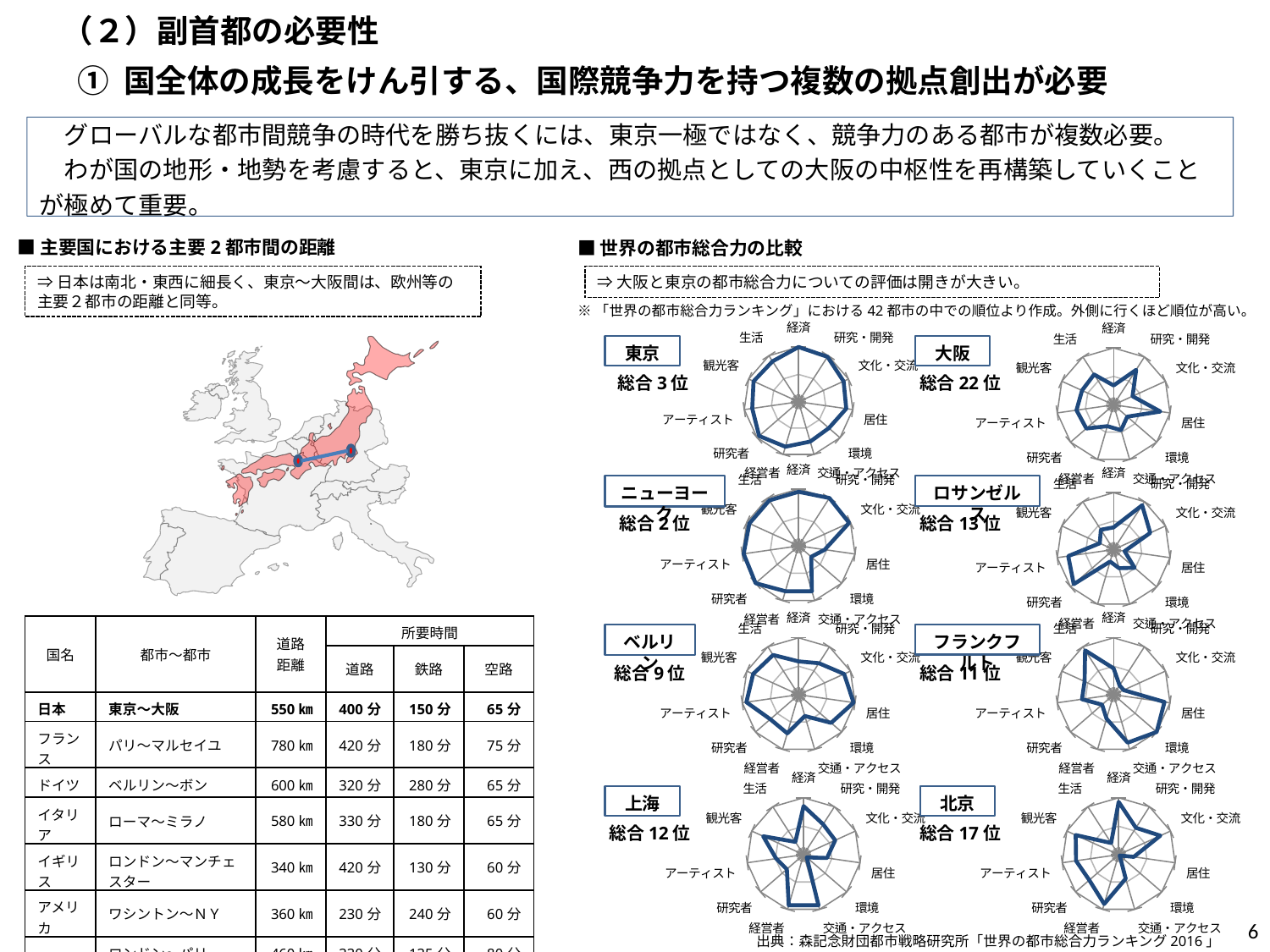
In the 「世界の都市総合力の比較」 section, what overall rank (総合) is printed next to the 大阪 radar chart? 総合 22 位 In the 「世界の都市総合力の比較」 section, what overall rank (総合) is printed next to the ニューヨーク radar chart? 総合 2 位 In the 「世界の都市総合力の比較」 section, what overall rank (総合) is printed next to the 上海 radar chart? 総合 12 位 In the 「世界の都市総合力の比較」 section, which city's radar chart is labelled with the worst (highest-numbered) overall rank? 大阪 What kind of chart is used in the 「世界の都市総合力の比較」 section to show each city's profile? radar chart According to the note above the radar charts, does a point further toward the outside of the chart indicate a higher or lower rank? higher rank In the 「世界の都市総合力の比較」 section, what overall rank (総合) is printed next to the 東京 radar chart? 総合 3 位 How many radar charts are shown in the 「世界の都市総合力の比較」 section? 8 In the 「世界の都市総合力の比較」 section, which has the better overall rank, ベルリン or フランクフルト? ベルリン In the 「世界の都市総合力の比較」 section, which city's radar chart is labelled with the best (lowest-numbered) overall rank? ニューヨーク In the 「世界の都市総合力の比較」 section, what overall rank (総合) is printed next to the 北京 radar chart? 総合 17 位 In the 「世界の都市総合力の比較」 section, how many rank positions separate 東京 (総合 3 位) and 大阪 (総合 22 位)? 19